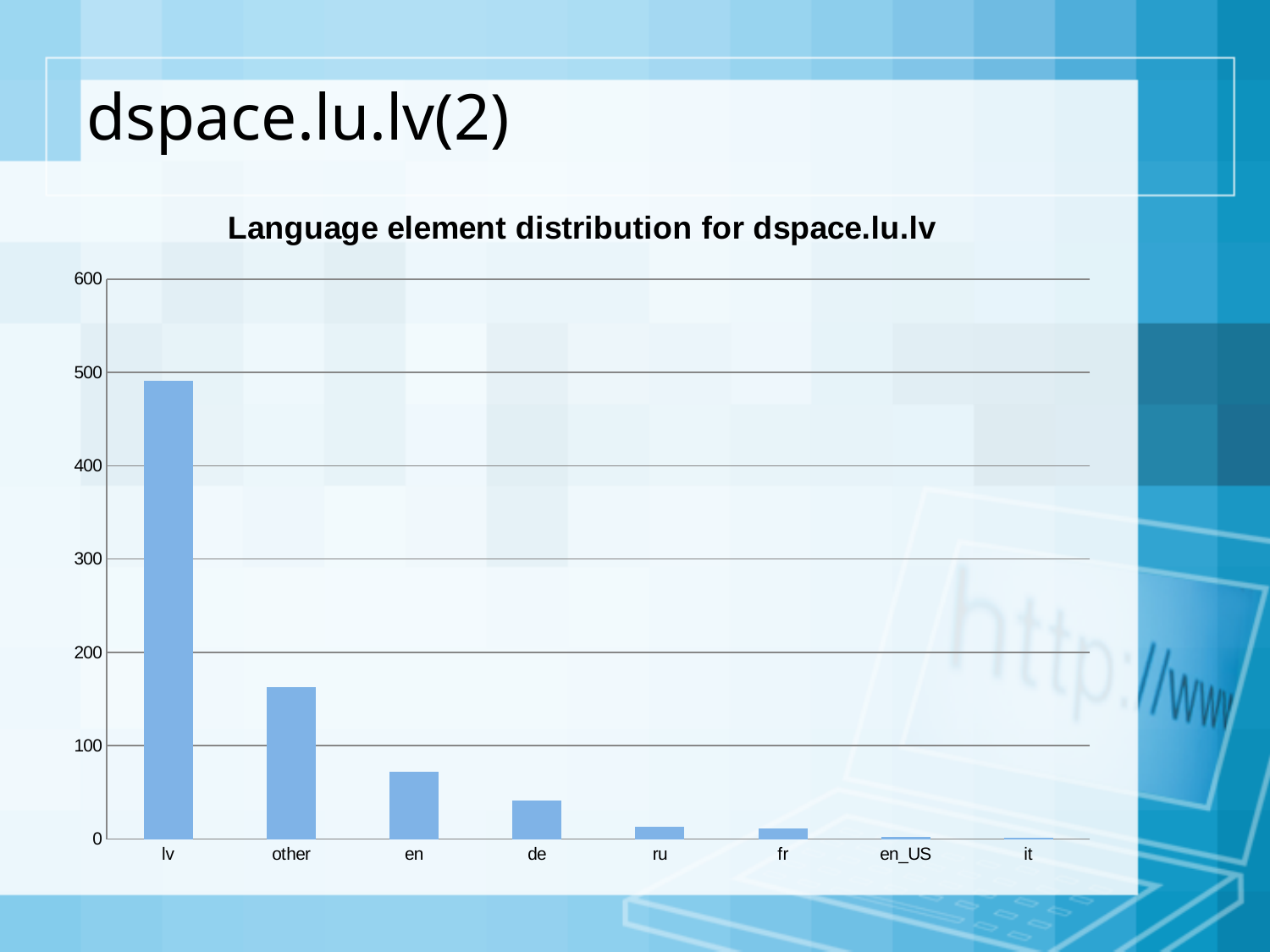
Which has a larger value, lv or other? lv What is the title of the chart? Language element distribution for dspace.lu.lv Which language category has the highest value? lv Is the value for de greater or less than 100? less How many language categories are shown on the x axis? 8 Is the value for en greater or less than 100? less Do the values rise or fall moving from left to right along the x axis? fall What kind of chart is shown on the slide? bar chart Is the value for lv greater or less than 400? greater Which has a larger value, en or de? en